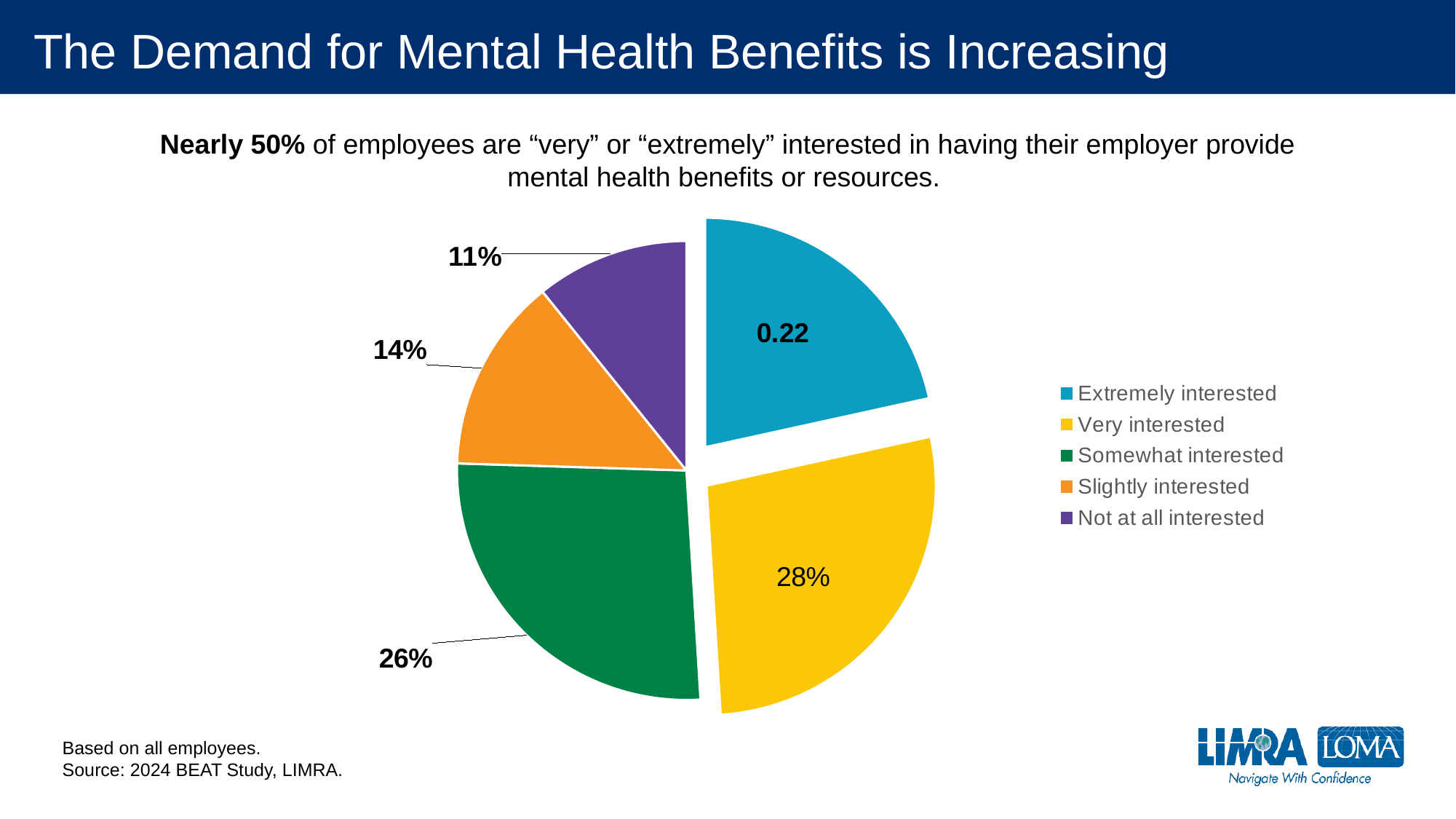
What percentage of employees are Slightly interested? 14% Which is larger, the Slightly interested share or the Not at all interested share? Slightly interested What colour is the Somewhat interested slice? green What kind of chart is shown on the slide? pie chart What value is printed on the Extremely interested slice? 0.22 What percentage of employees are Somewhat interested? 26% How many categories does the legend list? 5 What is the difference between the Very interested and Somewhat interested shares? 2% What percentage of employees are Very interested? 28% What percentage of employees are Not at all interested? 11% Which category has the largest share of the pie? Very interested Which category has the smallest share of the pie? Not at all interested